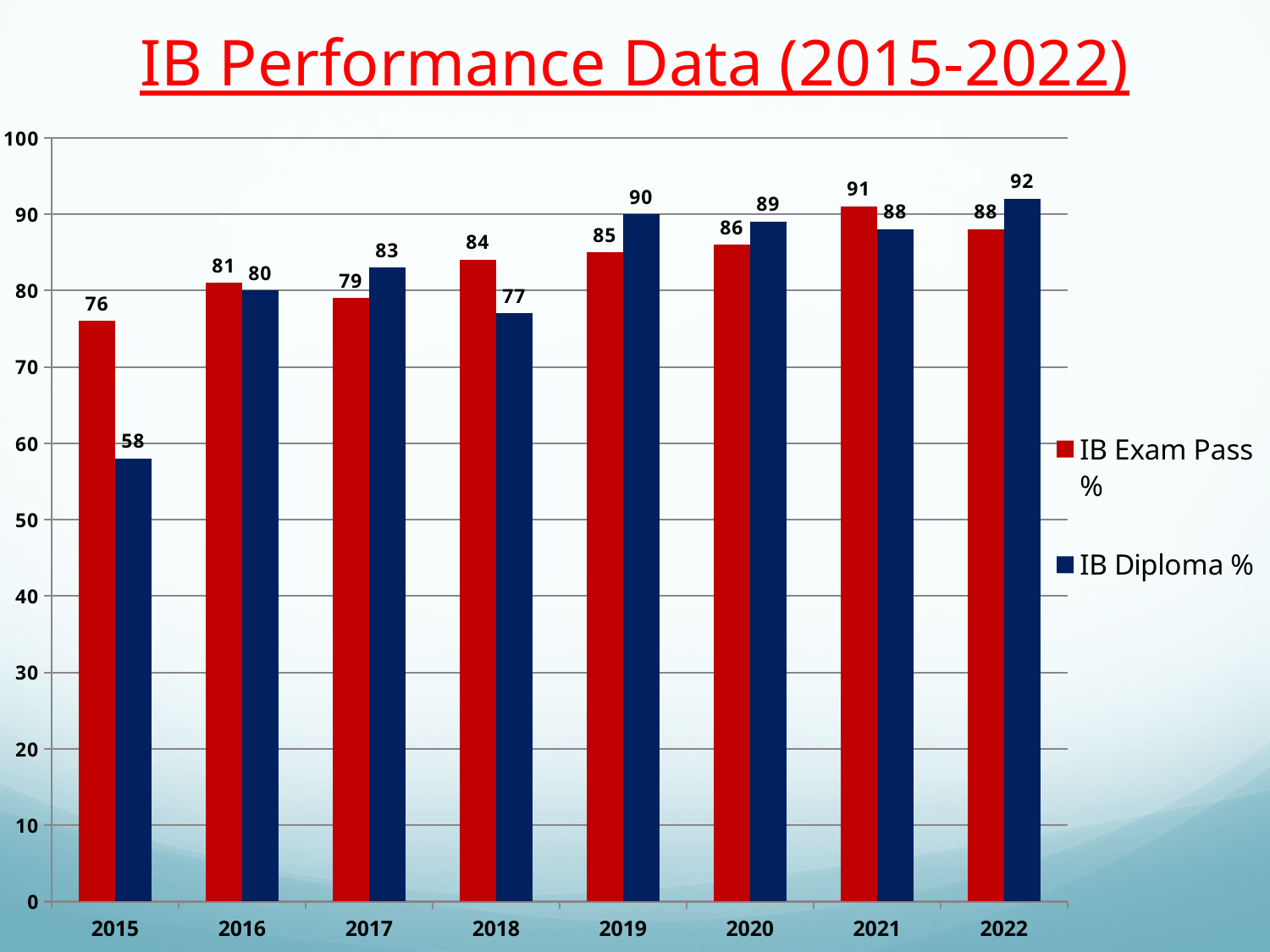
How many series does the legend list? 2 Which year has the lowest IB Diploma %? 2015 What kind of chart is shown on the slide? Bar chart What is the IB Diploma % for 2022? 92 What is the IB Exam Pass % for 2015? 76 In 2019, which is larger: the IB Exam Pass % or the IB Diploma %? IB Diploma % What is the difference between the IB Exam Pass % and the IB Diploma % in 2015? 18 How many years are shown on the x axis? 8 Which year has the highest IB Exam Pass %? 2021 What is the IB Diploma % for 2018? 77 What is the title of the chart? IB Performance Data (2015-2022) Does the IB Diploma % generally rise or fall from 2015 to 2022? Rise